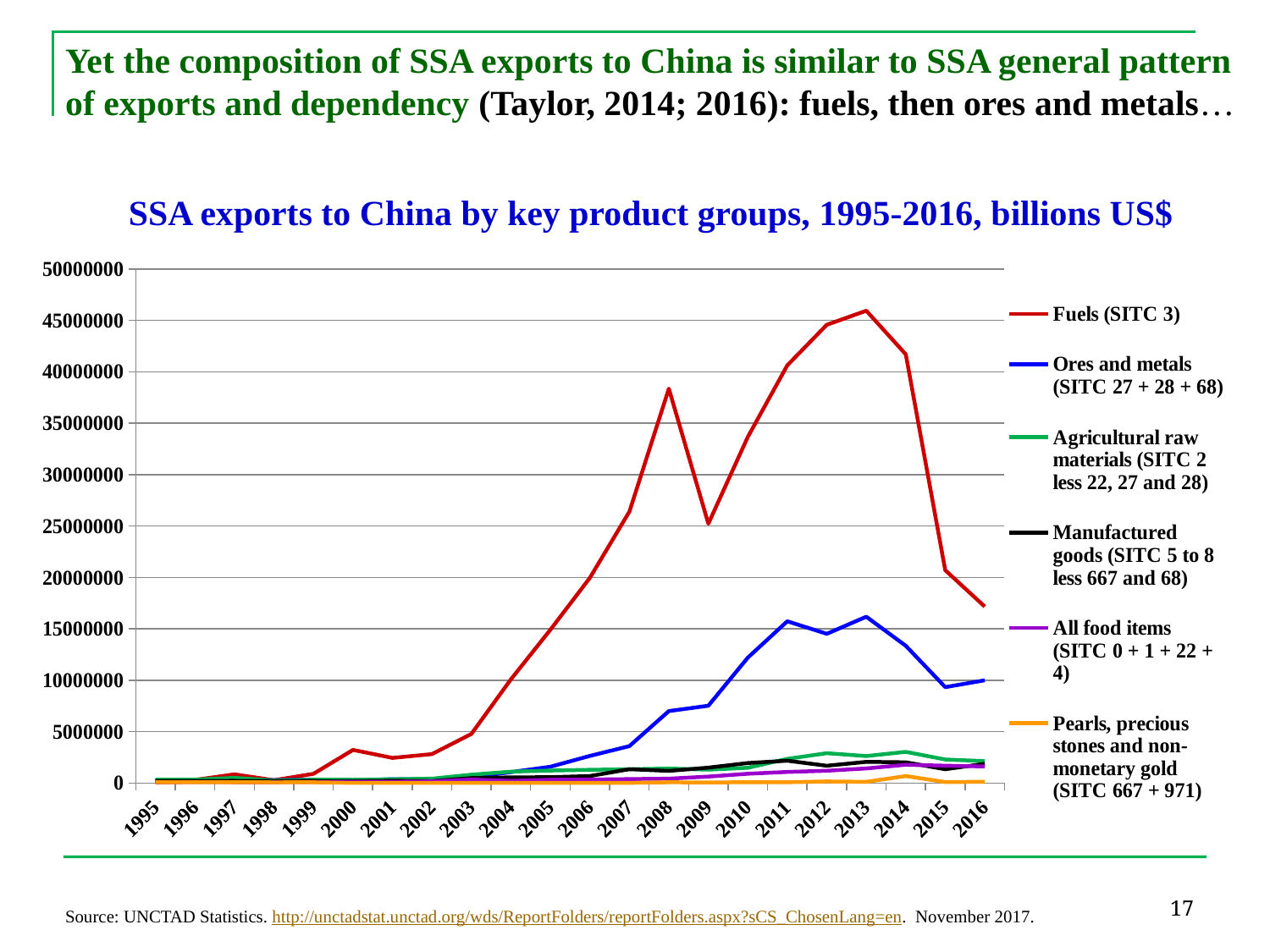
How many series does the legend list? 6 Is the value for Fuels (SITC 3) in 2016 greater or less than 20000000? less In 2013, which is larger: Fuels (SITC 3) or Ores and metals (SITC 27 + 28 + 68)? Fuels (SITC 3) Is the value for Fuels (SITC 3) in 2013 greater or less than 40000000? greater What kind of chart is shown on the slide? line chart How many years are plotted along the x axis? 22 Which product group reaches the highest value on the chart? Fuels (SITC 3) Do the values for Fuels (SITC 3) rise or fall from 2013 to 2016? fall Is the value for Fuels (SITC 3) in 2009 greater or less than 30000000? less What is the title of the chart? SSA exports to China by key product groups, 1995-2016, billions US$